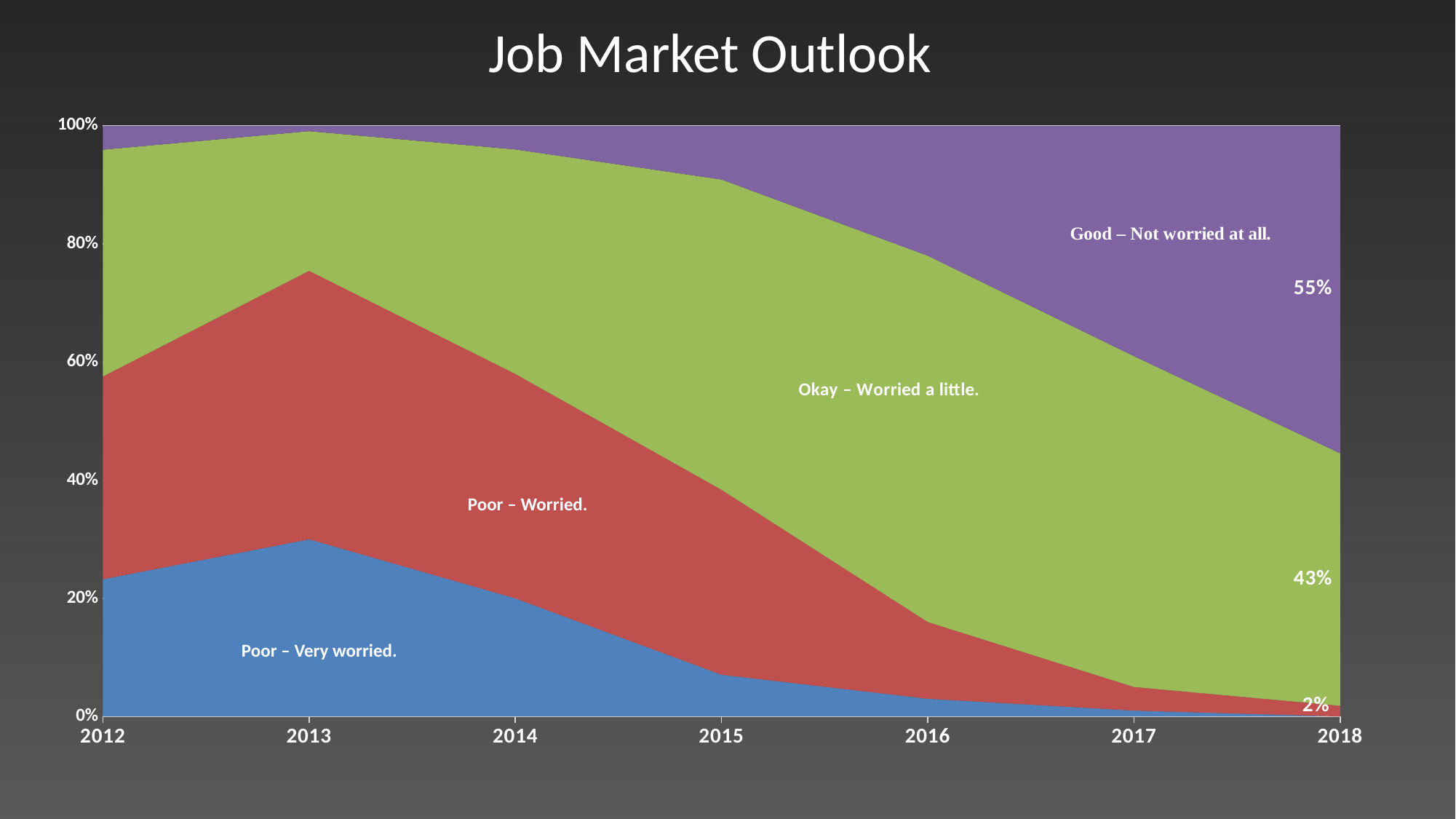
In 2018, what is the difference between the "Good – Not worried at all." share and the "Okay – Worried a little." share? 12 percentage points How many response categories are labelled within the chart areas? 4 What is the labelled value for "Good – Not worried at all." in 2018? 55% In which year is the "Poor – Very worried." share at its highest? 2013 In 2018, which is larger: "Good – Not worried at all." or "Okay – Worried a little."? Good – Not worried at all. Is the "Poor – Very worried." share in 2013 greater or less than 20%? greater What is the labelled value for "Okay – Worried a little." in 2018? 43% What is the title of the chart? Job Market Outlook Does the "Poor – Very worried." share rise or fall from 2013 to 2018? Fall What colour is the "Good – Not worried at all." area? Purple How many years are shown along the x axis? 7 What kind of chart is shown on the slide? Stacked area chart